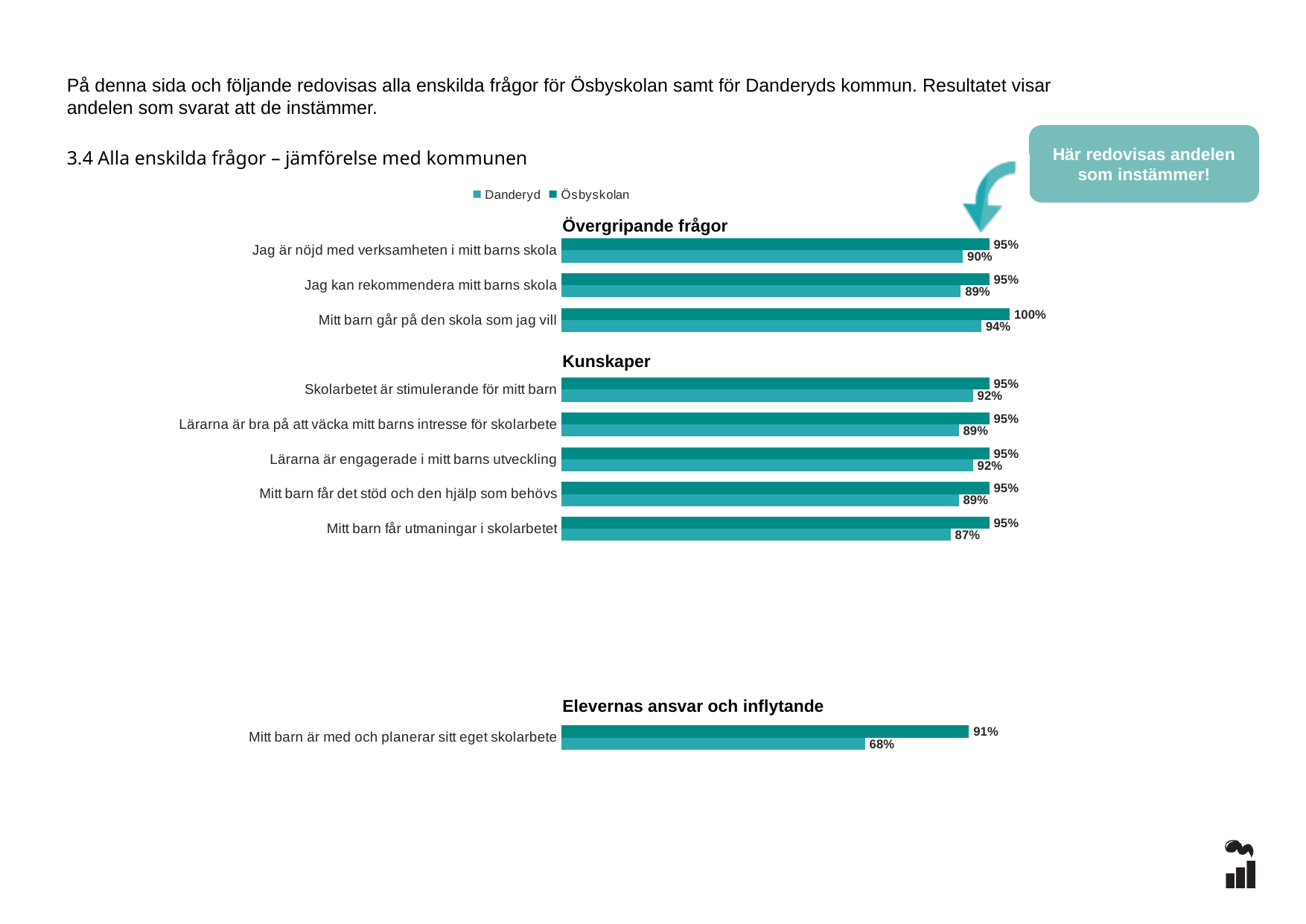
What is the Ösbyskolan value for "Mitt barn går på den skola som jag vill"? 100% What is the Danderyd value for "Mitt barn får utmaningar i skolarbetet"? 87% What is the Ösbyskolan value for "Mitt barn är med och planerar sitt eget skolarbete"? 91% How many questions (categories) are plotted in the chart? 9 For "Skolarbetet är stimulerande för mitt barn", which is larger: the Ösbyskolan value or the Danderyd value? Ösbyskolan What is the difference between the Ösbyskolan and Danderyd values for "Jag är nöjd med verksamheten i mitt barns skola"? 5 percentage points What is the Danderyd value for "Mitt barn är med och planerar sitt eget skolarbete"? 68% Which question has the highest Ösbyskolan value? Mitt barn går på den skola som jag vill Which question has the lowest Danderyd value? Mitt barn är med och planerar sitt eget skolarbete How many series does the legend list? 2 What is the difference between the Ösbyskolan and Danderyd values for "Mitt barn är med och planerar sitt eget skolarbete"? 23 percentage points What kind of chart is shown on the slide? Bar chart